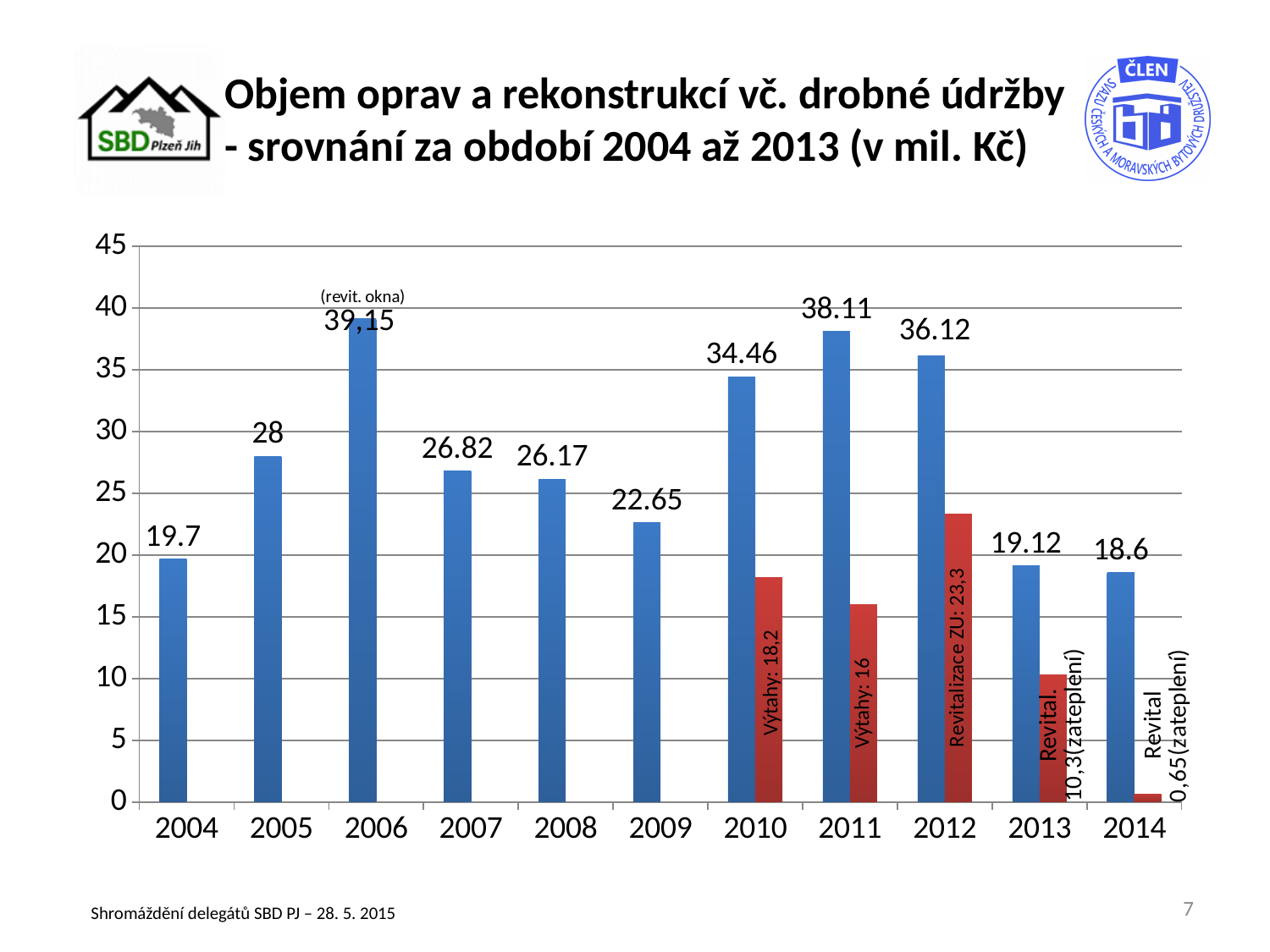
What is the difference between the blue bar values for 2011 and 2012? 1.99 Which year has the lowest blue bar? 2014 What is the value of the blue bar for 2004? 19.7 What value is labelled on the red bar for 2010 (Výtahy)? 18,2 What kind of chart is shown on the slide? bar chart What value is labelled on the red bar for 2012 (Revitalizace ZU)? 23,3 What is the difference between the blue bar values for 2005 and 2004? 8.3 Do the blue bar values rise or fall from 2006 to 2009? fall What is the value of the blue bar for 2011? 38.11 How many years are shown on the x axis? 11 Which year has the highest blue bar? 2006 Which year has the larger blue bar, 2007 or 2008? 2007